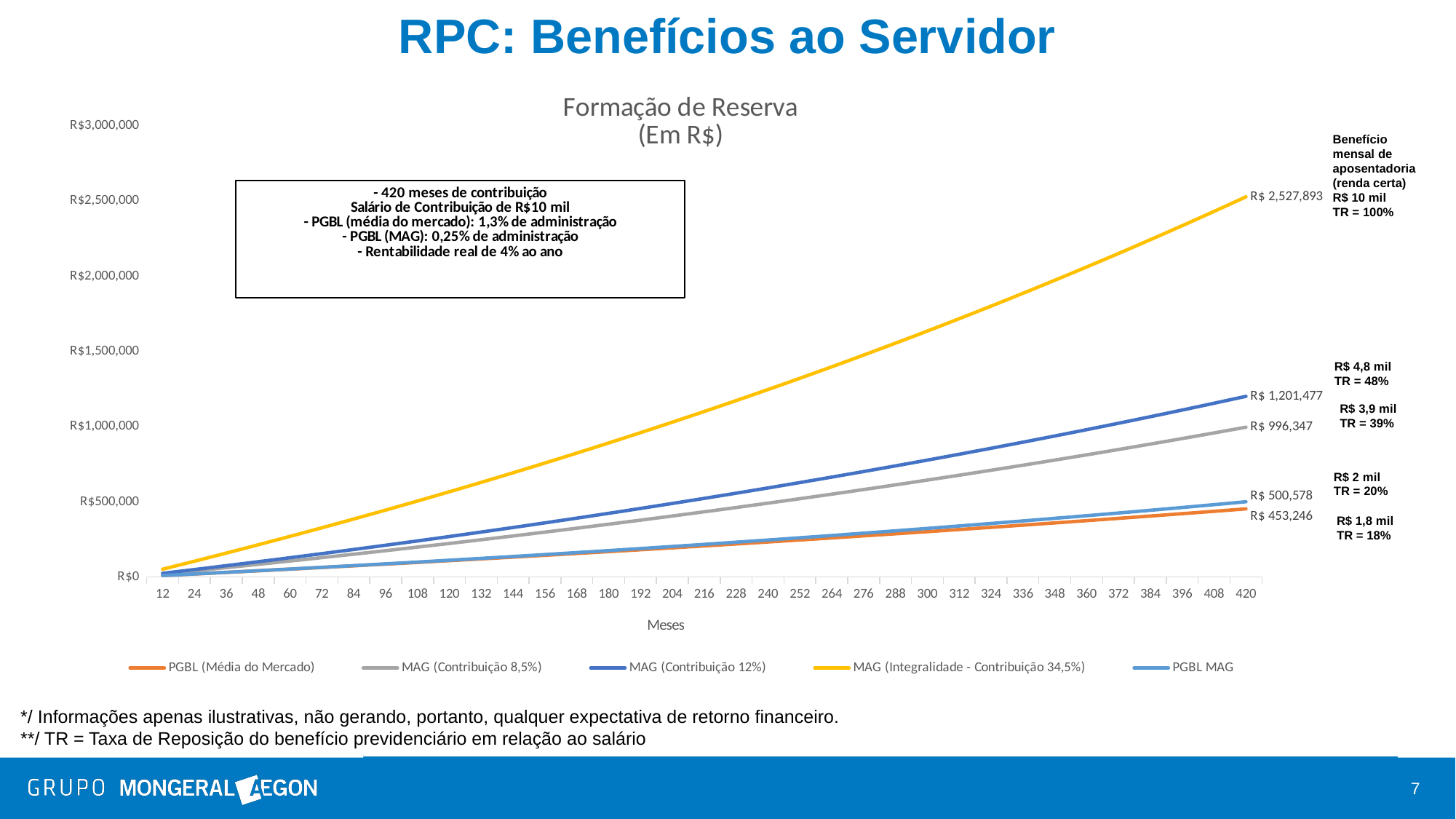
What is the value of the MAG (Contribuição 8,5%) series at 420 months? R$ 996,347 Do the values of the series rise or fall as the number of months increases? Rise What is the title of the chart? Formação de Reserva (Em R$) What is the value of the MAG (Integralidade - Contribuição 34,5%) series at 420 months? R$ 2,527,893 Which series has the lowest value at 420 months? PGBL (Média do Mercado) What kind of chart is shown on the slide? Line chart How many series does the chart legend list? 5 What is the value of the PGBL (Média do Mercado) series at 420 months? R$ 453,246 What is the value of the MAG (Contribuição 12%) series at 420 months? R$ 1,201,477 Which series reaches the highest value at 420 months? MAG (Integralidade - Contribuição 34,5%) What is the difference between the MAG (Contribuição 12%) and MAG (Contribuição 8,5%) values at 420 months? R$ 205,130 At 420 months, which is larger: PGBL MAG or PGBL (Média do Mercado)? PGBL MAG